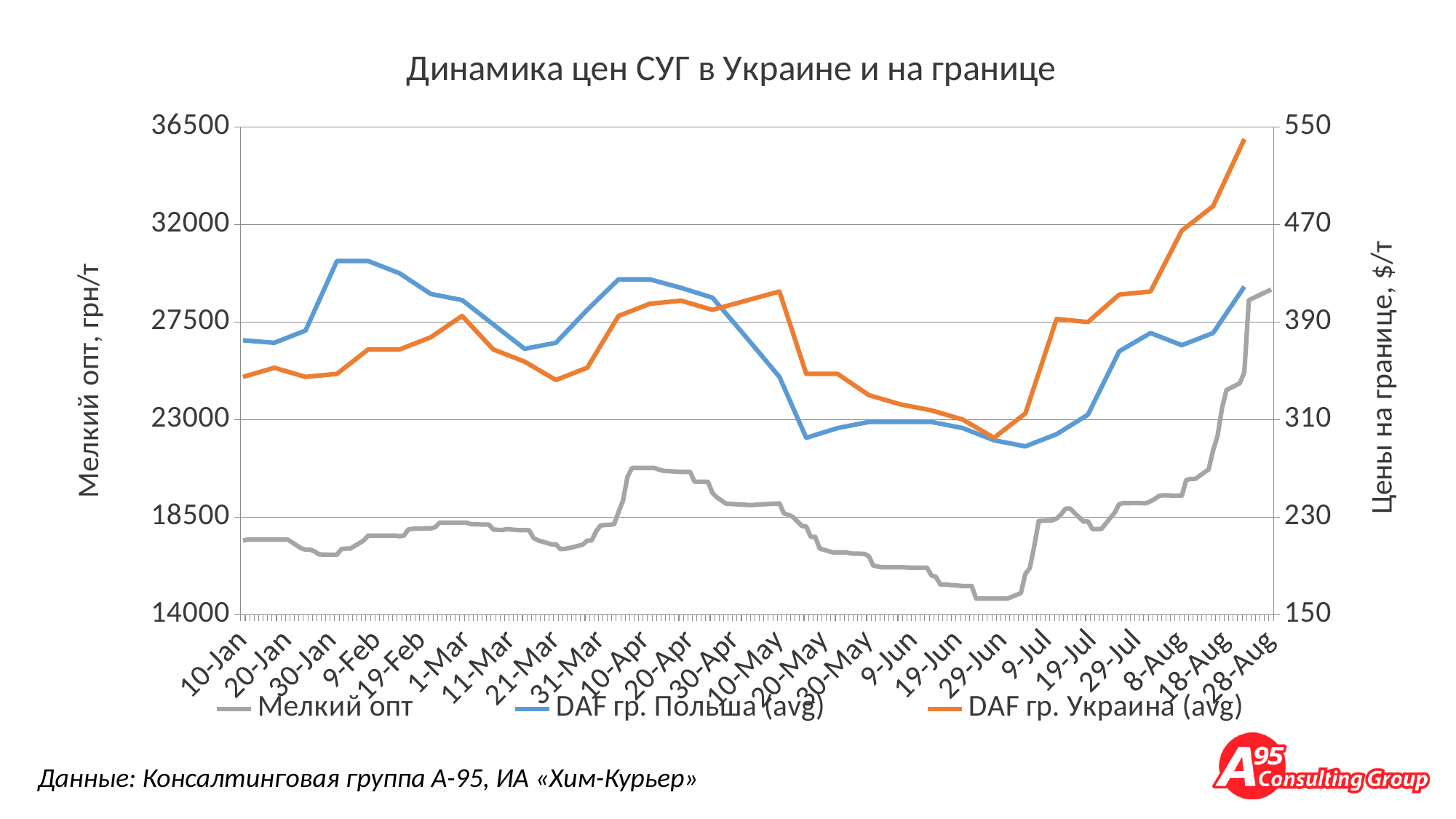
Does the Мелкий опт series rise or fall between 29-Jun and 28-Aug? rises How many series does the legend list? 3 Is the value for Мелкий опт at 29-Jun greater or less than 18500? less Does the DAF гр. Украина (avg) series rise or fall between 10-May and 29-Jun? falls At 28-Aug, which is higher: DAF гр. Польша (avg) or DAF гр. Украина (avg)? DAF гр. Украина (avg) What is the title of the chart? Динамика цен СУГ в Украине и на границе Is the value for DAF гр. Польша (avg) at 9-Jul greater or less than 310? less Is the value for Мелкий опт at 28-Aug greater or less than 27500? greater What is the label of the right-hand vertical axis? Цены на границе, $/т What kind of chart is shown on the slide? line chart